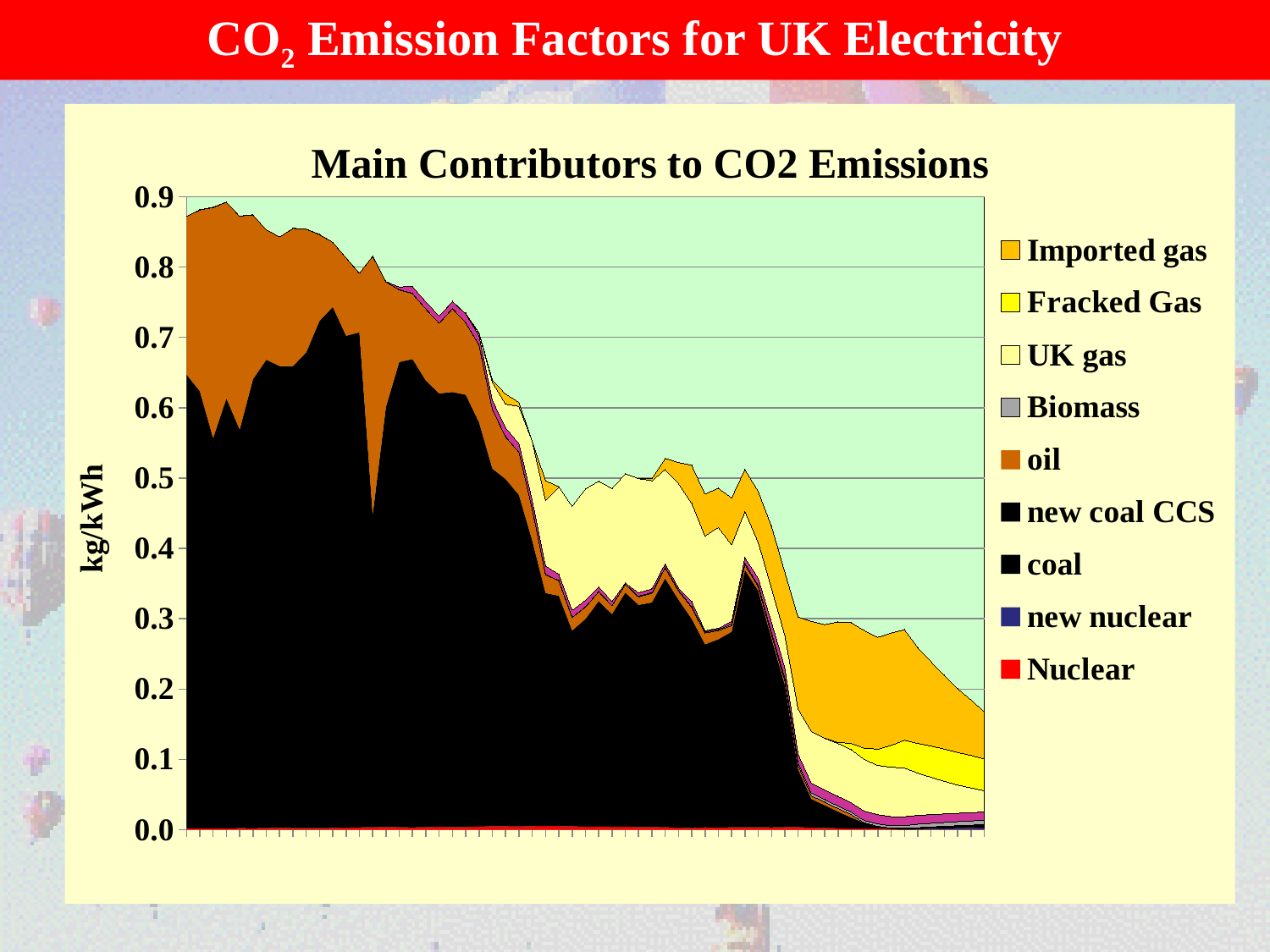
Which series is listed first in the chart's legend? Imported gas How many series does the legend of the chart list? 9 Is the total stacked value at the left edge of the chart greater or less than 0.8? greater Which series is listed last in the chart's legend? Nuclear Is the total stacked value at the right edge of the chart greater or less than 0.1? greater What is the highest value shown on the vertical axis of the chart? 0.9 Is the total stacked value at the right edge of the chart greater or less than 0.2? less What kind of chart is shown on the slide? Stacked area chart Does the total stacked value rise or fall from left to right along the x axis? Fall